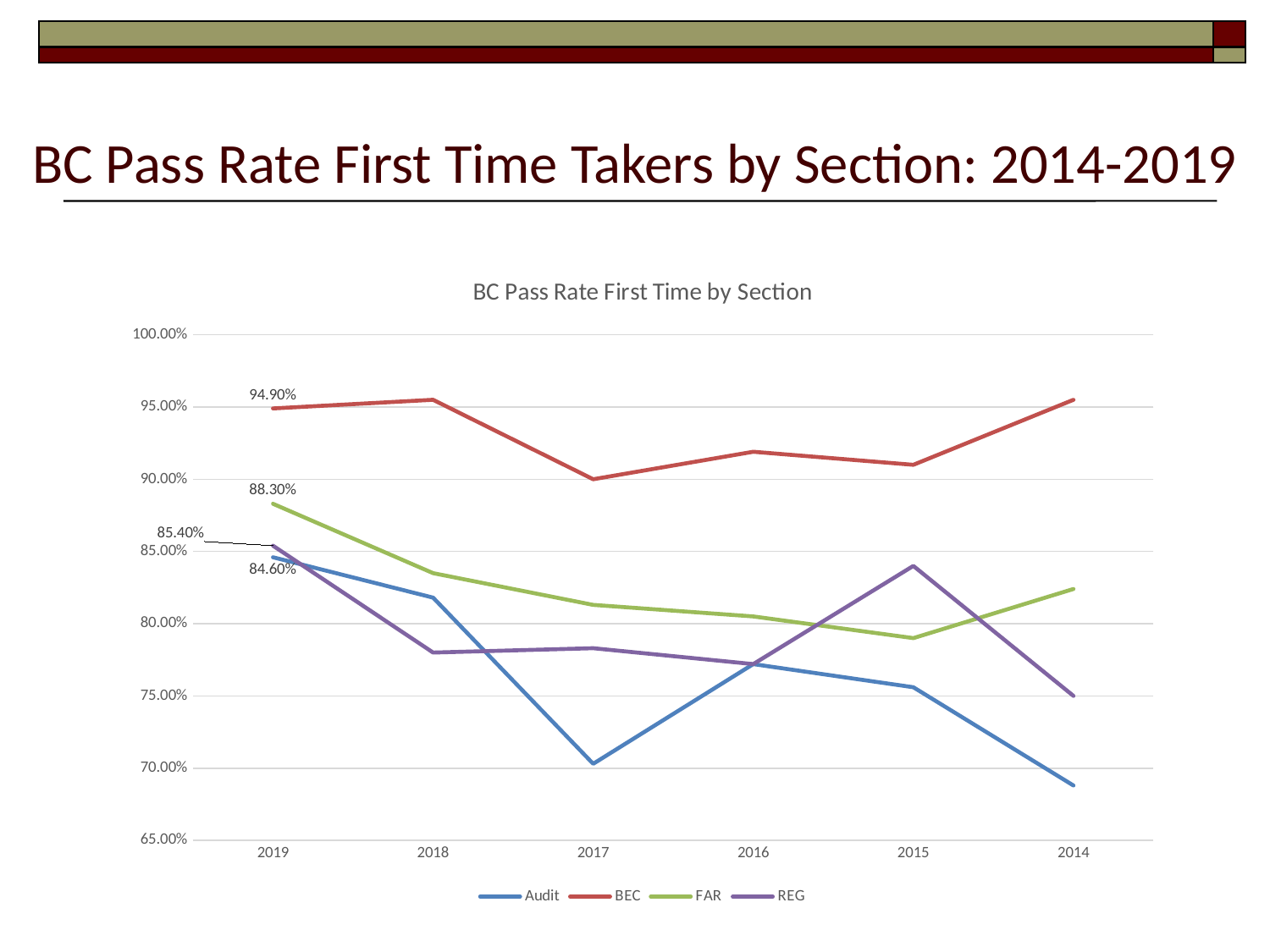
How many years are shown on the x axis? 6 What is the Audit pass rate for 2019? 84.60% What kind of chart is shown on the slide? Line chart How many series does the legend list? 4 What is the difference between the BEC and FAR pass rates in 2019? 6.60% What is the REG pass rate for 2019? 85.40% Which section has the lowest pass rate in 2014? Audit What is the FAR pass rate for 2019? 88.30% Is the Audit pass rate for 2017 greater or less than 75.00%? less What is the BEC pass rate for 2019? 94.90% Is the BEC pass rate for 2016 greater or less than 90.00%? greater Which section has the highest pass rate in 2019? BEC